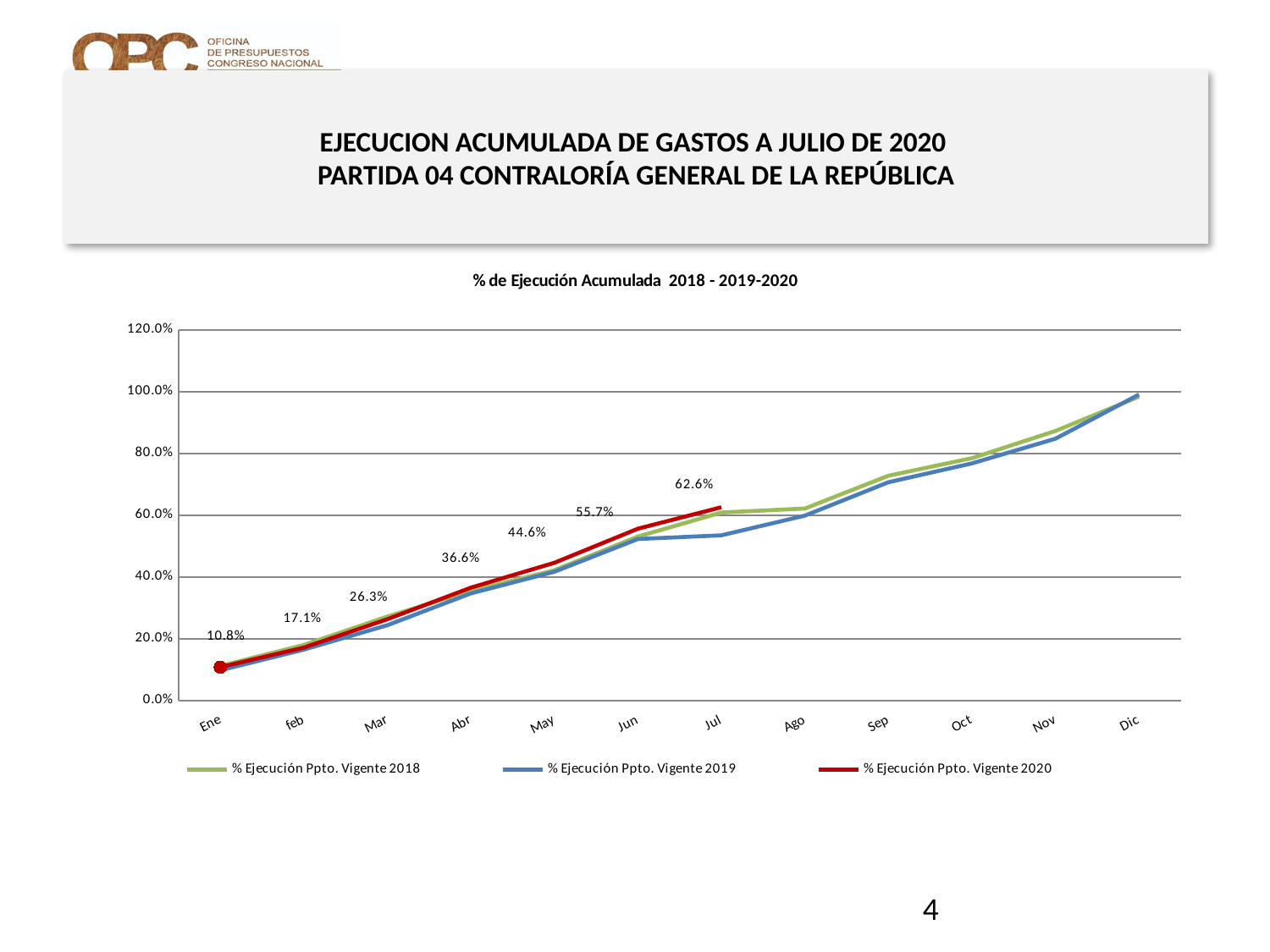
What is the value for % Ejecución Ppto. Vigente 2020 in May? 44.6% Is the value for % Ejecución Ppto. Vigente 2019 in Dic greater or less than 80.0%? greater Does the % Ejecución Ppto. Vigente 2020 series rise or fall from Ene to Jul? rise What is the value for % Ejecución Ppto. Vigente 2020 in Ene? 10.8% What is the difference between the % Ejecución Ppto. Vigente 2020 values for Jul and Jun? 6.9% How many months are shown on the x axis? 12 What is the value for % Ejecución Ppto. Vigente 2020 in Mar? 26.3% What is the difference between the % Ejecución Ppto. Vigente 2020 values for Abr and Feb? 19.5% What is the title of the chart? % de Ejecución Acumulada 2018 - 2019-2020 How many series does the legend list? 3 What is the value for % Ejecución Ppto. Vigente 2020 in Jul? 62.6% What type of chart is shown on the slide? line chart